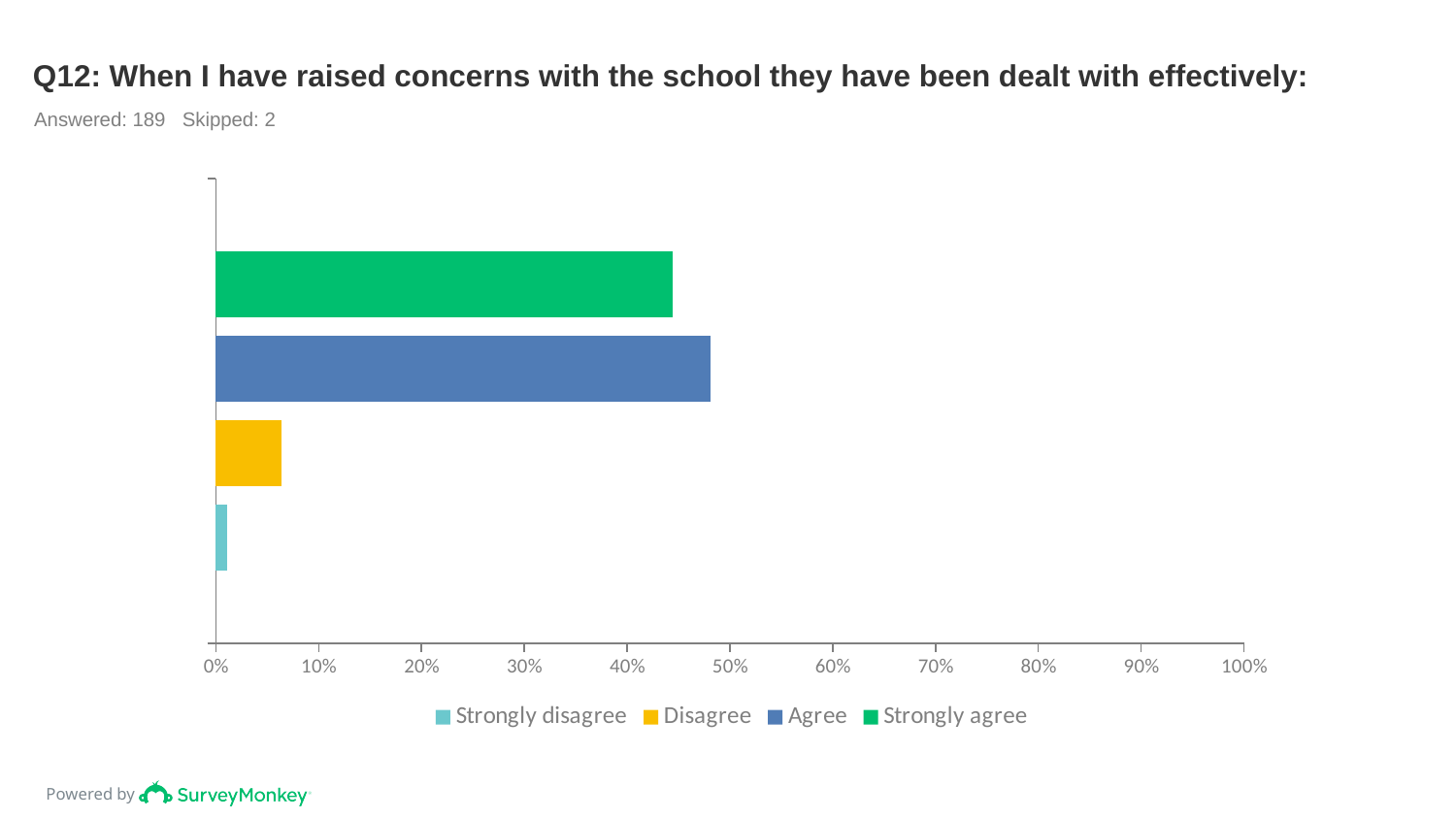
Which is larger, the value for Disagree or the value for Strongly disagree? Disagree Is the value for Strongly disagree greater or less than 10%? less Which response category has the longest bar? Agree Is the value for Strongly agree greater or less than 40%? greater What kind of chart is shown on the slide? Bar chart How many series does the legend list? 4 How many respondents answered this question according to the slide? 189 What colour represents Disagree in the legend? Yellow Is the value for Disagree greater or less than 10%? less Which response category has the shortest bar? Strongly disagree Which is larger, the value for Agree or the value for Disagree? Agree